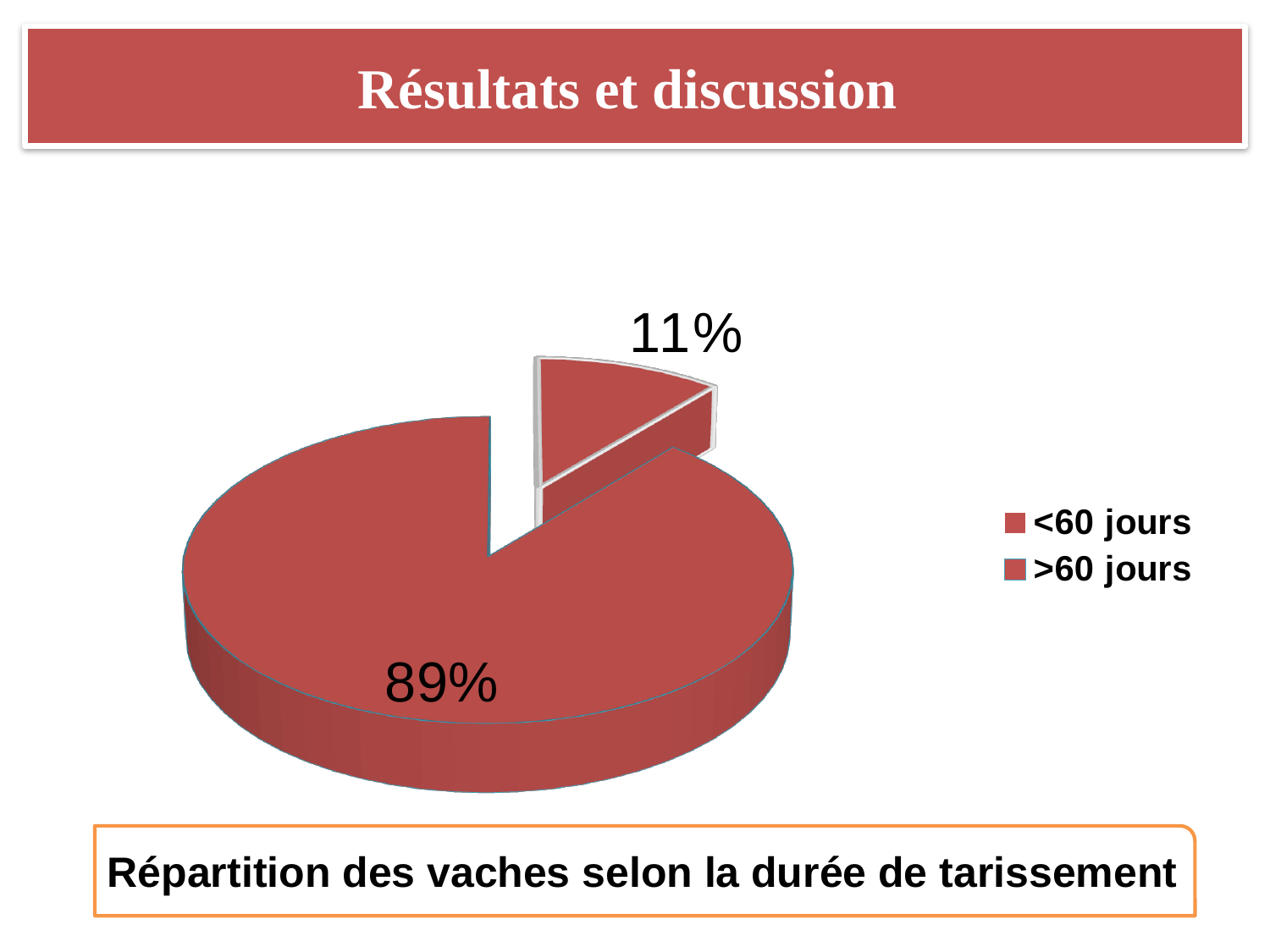
How many entries does the legend of the pie chart list? 2 What is the total of the two percentages shown on the pie chart? 100% What percentage is shown on the smaller, exploded slice of the pie chart? 11% What percentage is shown on the larger slice of the pie chart? 89% What is the difference in percentage points between the larger slice and the smaller slice of the pie chart? 78 What is the largest share shown in the pie chart? 89% What is the smallest share shown in the pie chart? 11% How many slices does the pie chart have? 2 What is the caption below the pie chart? Répartition des vaches selon la durée de tarissement What kind of chart is shown on the slide? pie chart What are the two legend entries of the pie chart? <60 jours and >60 jours Which is larger in the pie chart, the exploded slice or the remaining slice? the remaining slice